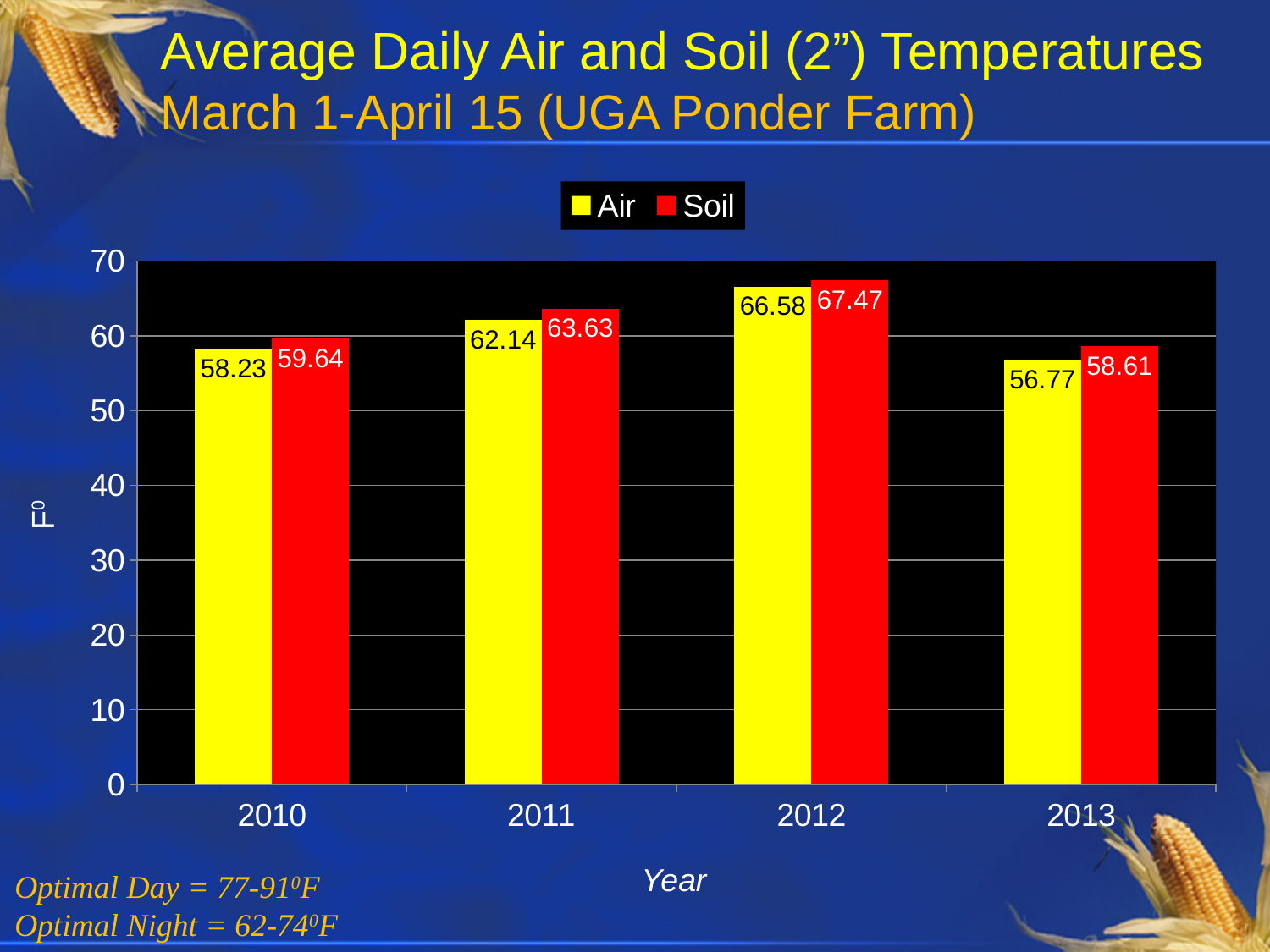
How many series does the legend list? 2 What is the Soil temperature value for 2013? 58.61 What kind of chart is shown on the slide? bar chart What is the Air temperature value for 2010? 58.23 Is the Air value for 2012 greater or less than 60? greater Which year has the lowest Soil temperature? 2013 What is the difference between the Soil and Air temperatures in 2011? 1.49 What is the Soil temperature value for 2012? 67.47 Which is larger in 2013, the Air value or the Soil value? Soil Which colour represents the Soil series in the legend? red How many years are shown on the x axis? 4 Which year has the highest Air temperature? 2012